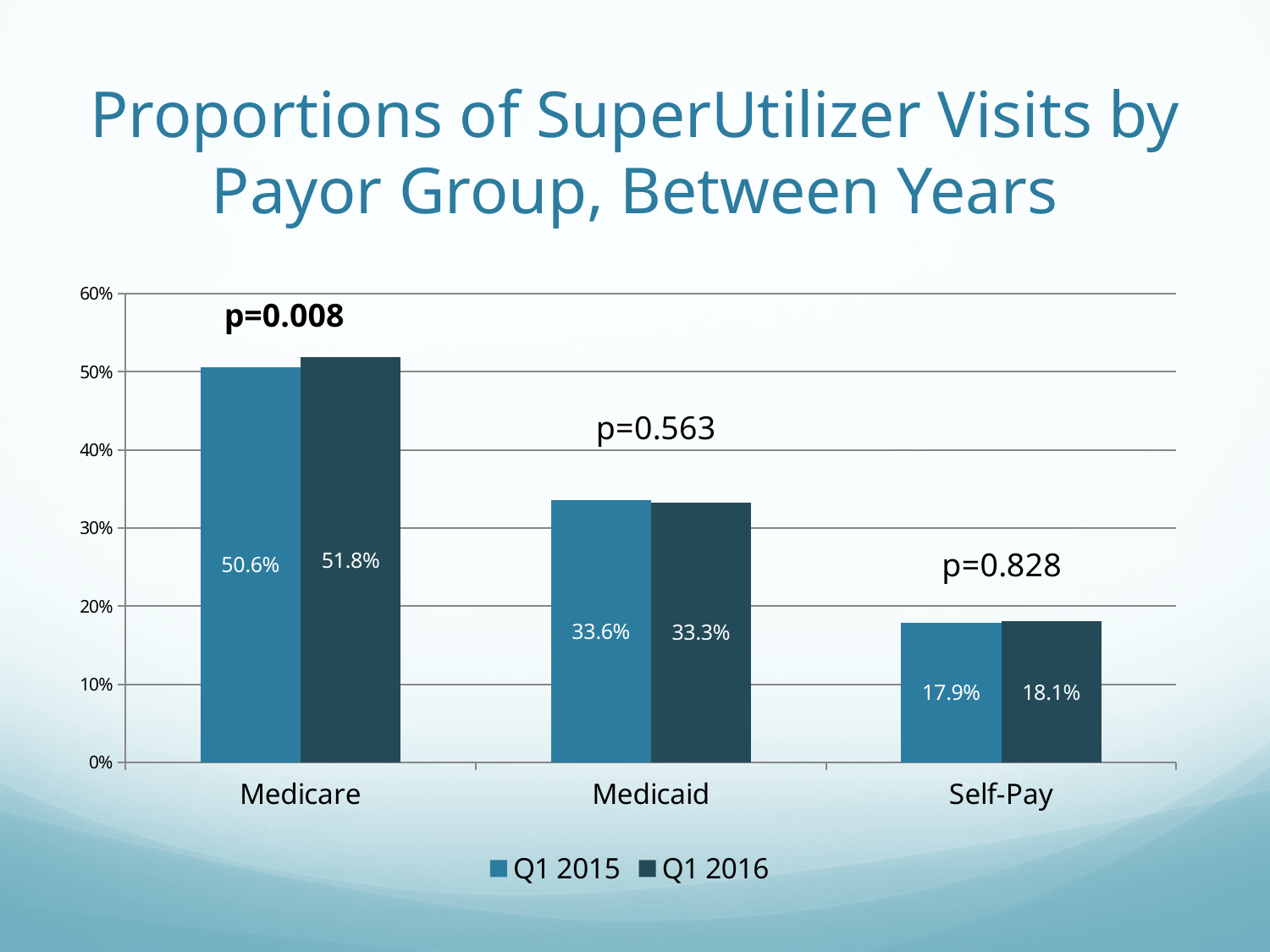
What is the Q1 2016 value for Medicaid? 33.3% What kind of chart is shown on the slide? Bar chart How many series does the legend list? 2 What is the difference between the Q1 2015 values for Medicare and Medicaid? 17.0% How many payor groups are shown on the x axis? 3 Is the Q1 2015 value for Medicaid greater or less than 30%? greater Which is larger: the Q1 2015 value for Medicaid or the Q1 2016 value for Self-Pay? Q1 2015 value for Medicaid What is the Q1 2016 value for Self-Pay? 18.1% Which payor group has the lowest Q1 2015 value? Self-Pay What is the Q1 2015 value for Medicare? 50.6% What is the difference between the Q1 2016 and Q1 2015 values for Medicare? 1.2% Which payor group has the highest Q1 2016 value? Medicare